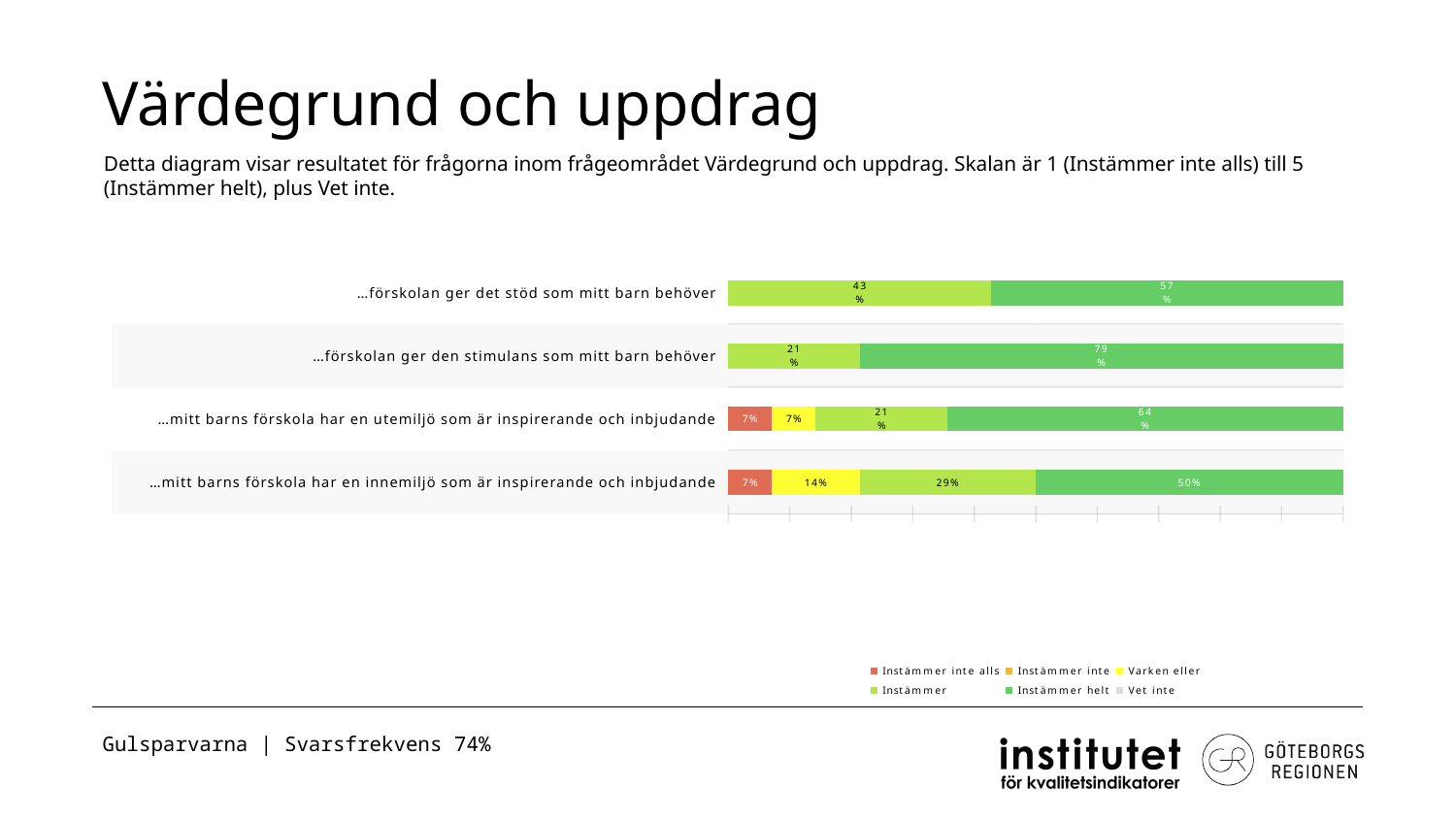
What kind of chart is shown on the slide? Stacked bar chart Which statement has the highest 'Instämmer helt' value? …förskolan ger den stimulans som mitt barn behöver What is the 'Instämmer helt' value for '…mitt barns förskola har en innemiljö som är inspirerande och inbjudande'? 50% What is the difference between the 'Instämmer helt' values for '…förskolan ger den stimulans som mitt barn behöver' and '…förskolan ger det stöd som mitt barn behöver'? 22% What is the 'Instämmer' value for '…förskolan ger det stöd som mitt barn behöver'? 43% Which is larger: the 'Instämmer' value for '…mitt barns förskola har en innemiljö som är inspirerande och inbjudande' or for '…mitt barns förskola har en utemiljö som är inspirerande och inbjudande'? …mitt barns förskola har en innemiljö som är inspirerande och inbjudande What is the 'Instämmer helt' value for '…förskolan ger den stimulans som mitt barn behöver'? 79% How many series does the legend list? 6 Which statement has the lowest 'Instämmer helt' value? …mitt barns förskola har en innemiljö som är inspirerande och inbjudande How many question statements (categories) are plotted in the chart? 4 Which legend entry is shown in red? Instämmer inte alls What is the 'Varken eller' value for '…mitt barns förskola har en utemiljö som är inspirerande och inbjudande'? 7%